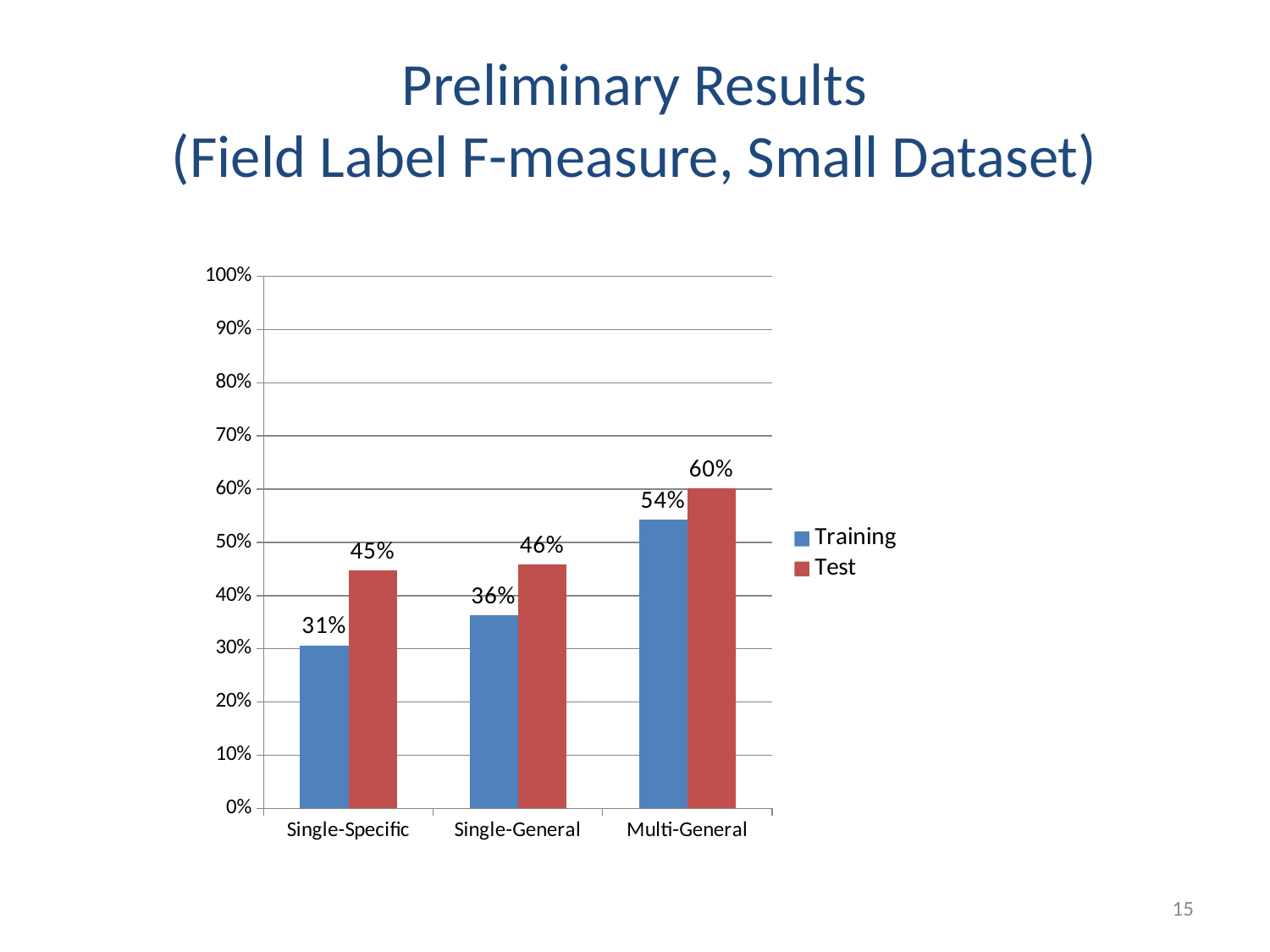
What is the difference between the Test and Training values for Single-Specific? 14% Which category has the lowest Training value? Single-Specific How many categories are shown on the x axis? 3 Do the Training values rise or fall from Single-Specific to Multi-General? Rise How many series does the legend list? 2 What is the difference between the Training values for Multi-General and Single-General? 18% What kind of chart is shown on the slide? Bar chart What is the Training value for Single-General? 36% Which category has the highest Test value? Multi-General What is the Test value for Multi-General? 60% Which is larger, the Test value for Single-General or the Training value for Multi-General? Training value for Multi-General What is the Training value for Single-Specific? 31%